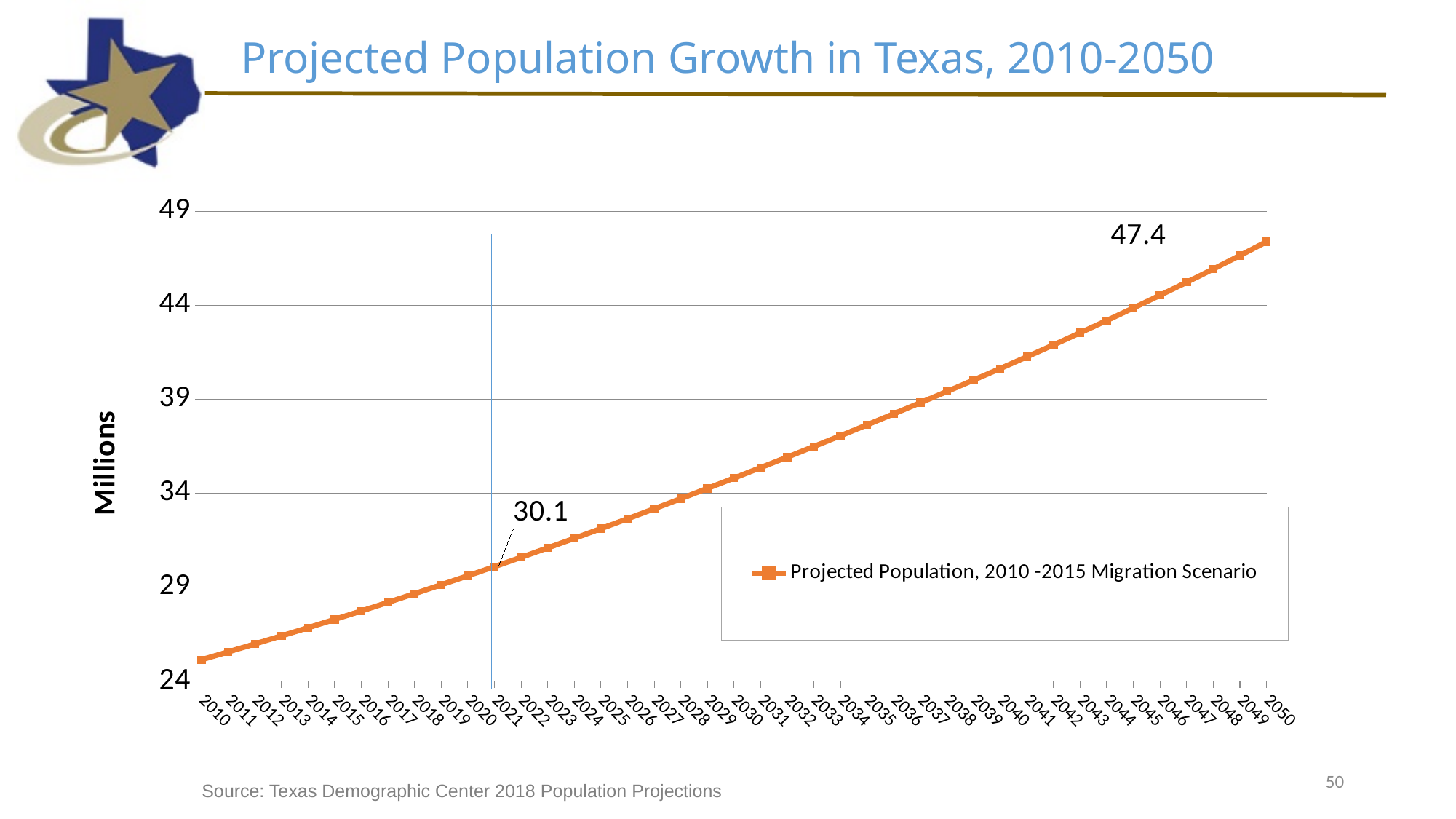
What is the difference between the labelled values for 2050 and 2021? 17.3 What kind of chart is shown on the slide? line chart Which year has the lowest projected population? 2010 What is the projected population value labelled for 2021? 30.1 What is the projected population value shown for 2050? 47.4 Is the value for 2040 greater or less than 39? greater Which year has the highest projected population? 2050 Is the value for 2010 greater or less than 29? less Does the projected population rise or fall from 2010 to 2050? rise How many series does the legend list? 1 What is the label on the y axis? Millions How many years are plotted along the x axis? 41